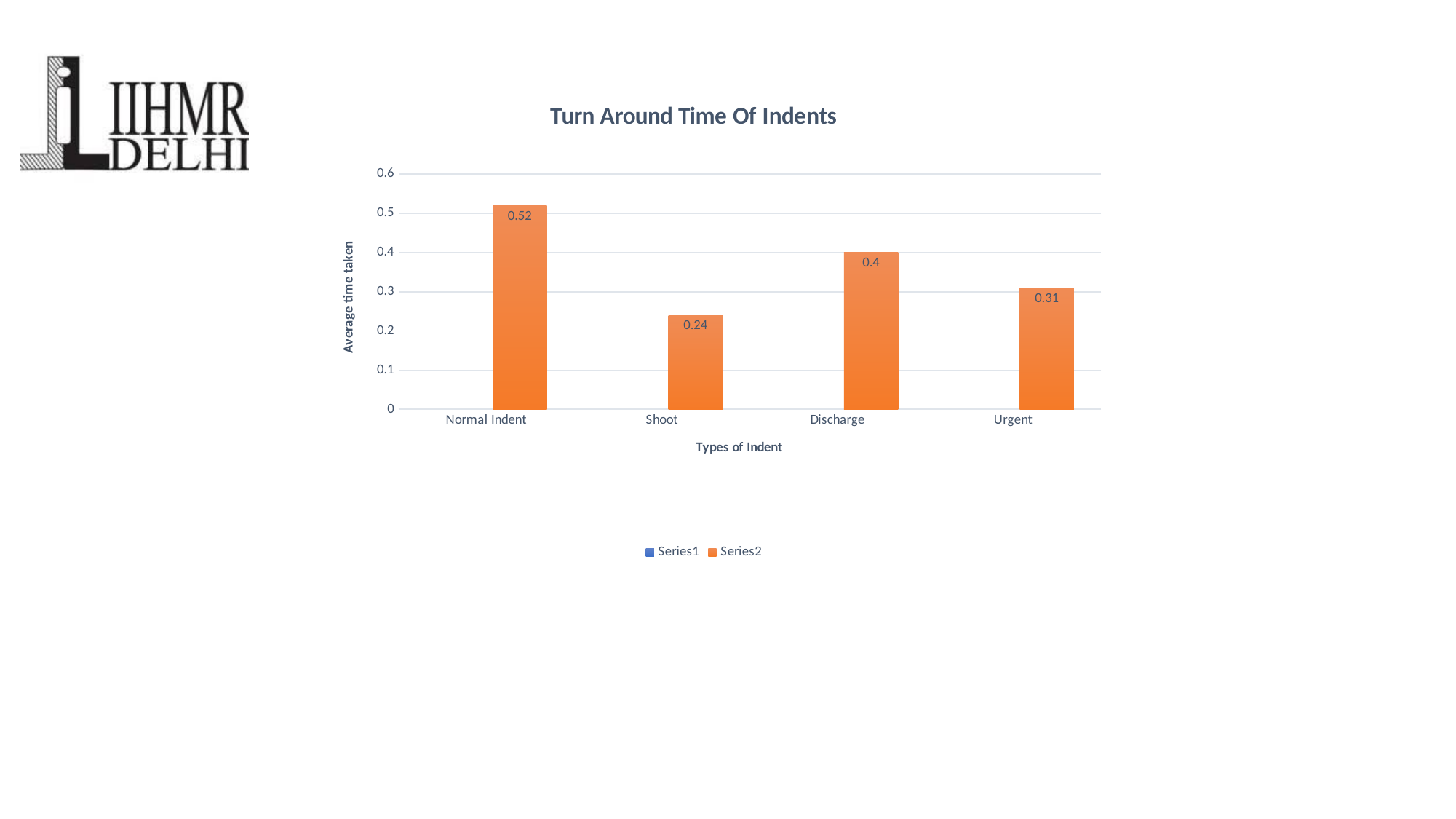
How many series does the legend list? 2 What is the difference between the values for Normal Indent and Shoot? 0.28 Which type of indent has the lowest average time taken? Shoot Is the value for Urgent greater or less than 0.4? less What kind of chart is shown on the slide? bar chart What is the value for Shoot? 0.24 Which type of indent has the highest average time taken? Normal Indent How many types of indent are shown on the x axis? 4 Which is larger, the value for Discharge or the value for Urgent? Discharge What is the value for Discharge? 0.4 What is the value for Normal Indent? 0.52 What is the value for Urgent? 0.31